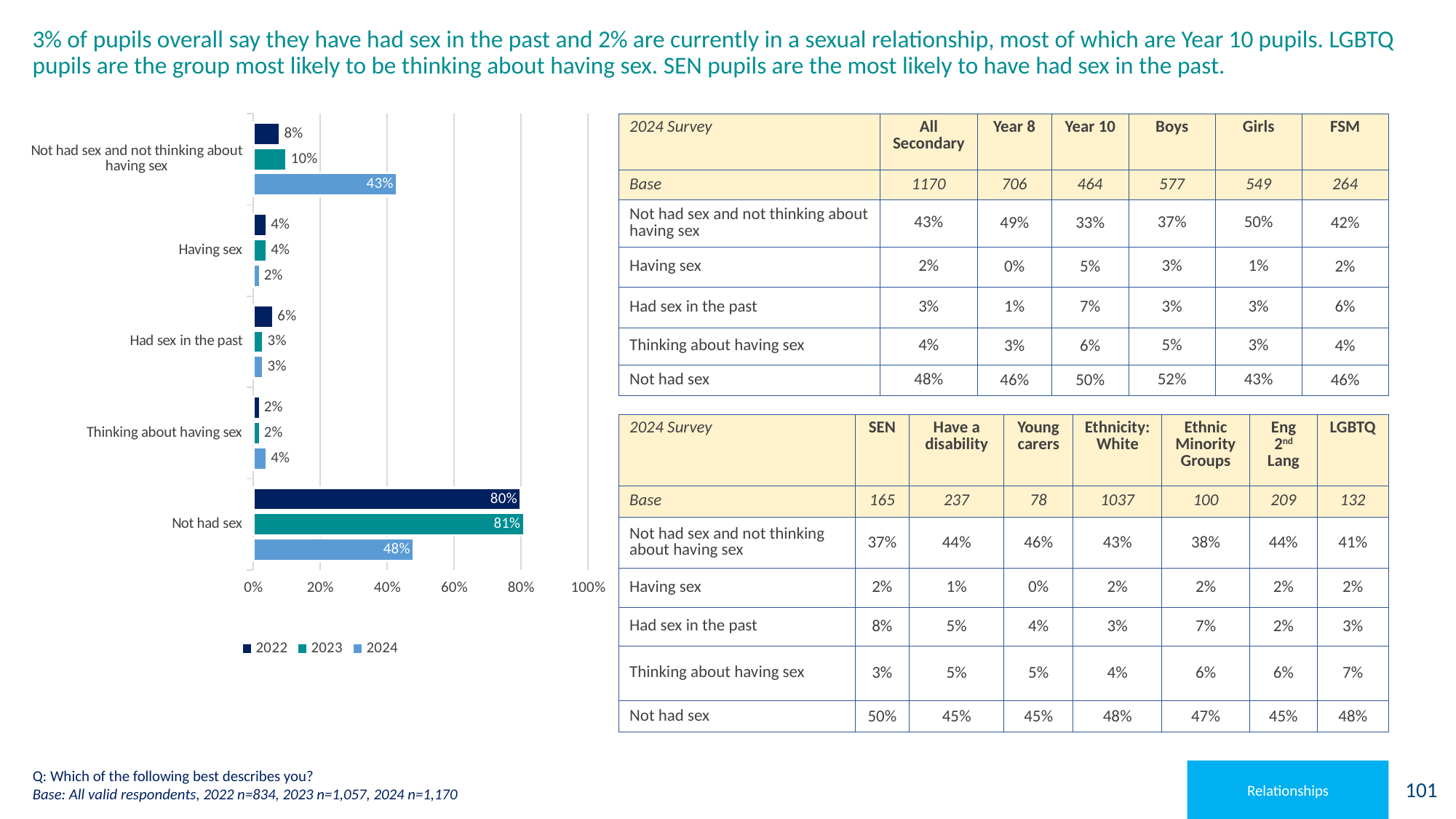
Which category has the lowest 2022 value in the bar chart? Thinking about having sex What is the 2023 value for 'Not had sex' in the bar chart? 81% Which years are listed in the bar chart legend? 2022, 2023, 2024 What is the 2024 value for 'Not had sex and not thinking about having sex' in the bar chart? 43% What is the 2022 value for 'Had sex in the past' in the bar chart? 6% What kind of chart is shown on the slide? bar chart Is the 2022 value for 'Not had sex' in the bar chart greater or less than 60%? greater What is the difference between the 2023 and 2024 values for 'Not had sex' in the bar chart? 33% Which category has the highest 2024 value in the bar chart? Not had sex In the bar chart, is the 2024 value for 'Not had sex and not thinking about having sex' larger than the 2023 value? Yes How many series does the bar chart legend list? 3 How many categories are shown in the bar chart? 5